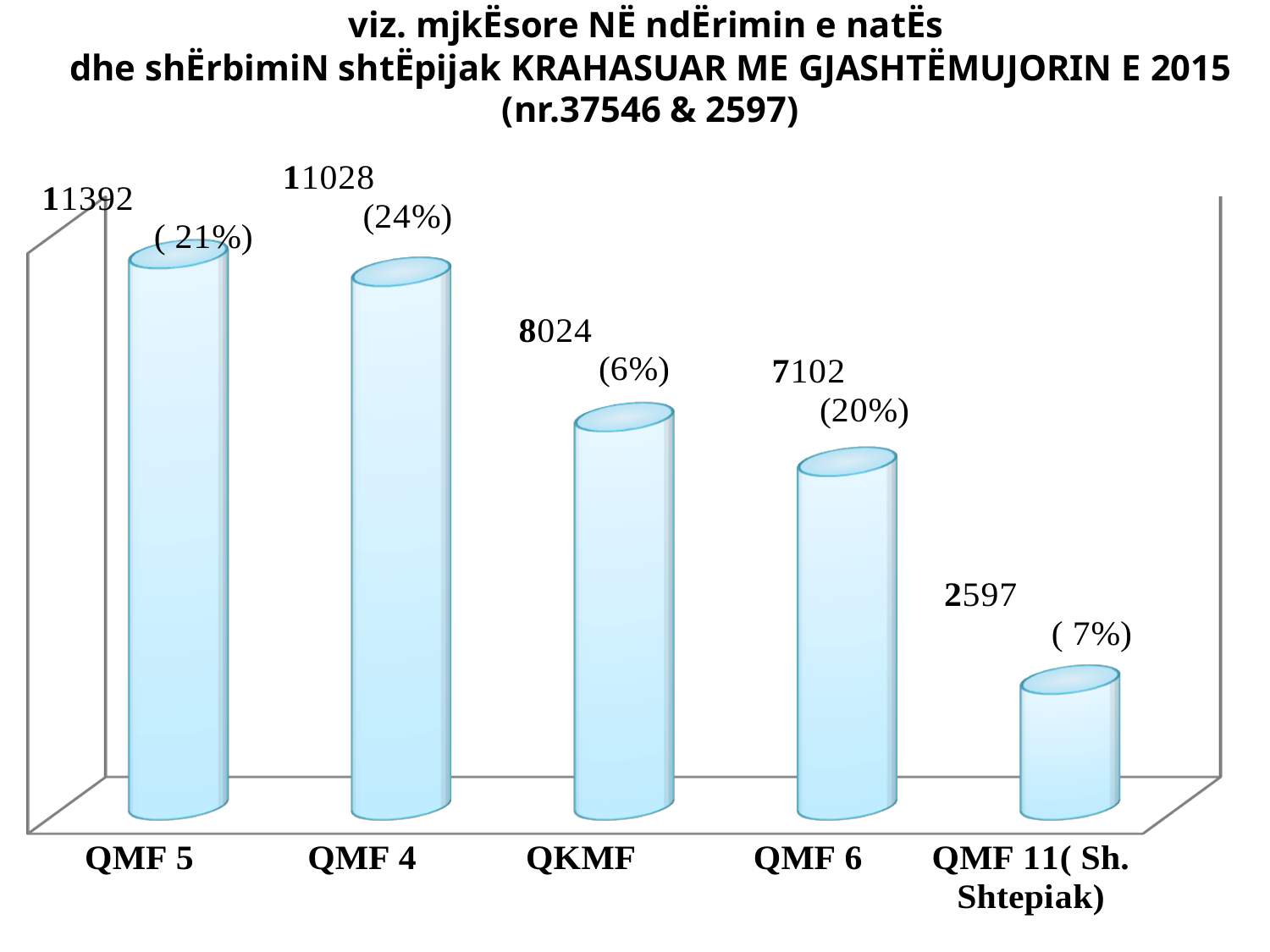
What is the value shown for QMF 5? 11392 How many categories are shown on the x axis? 5 What is the value shown for QKMF? 8024 Which is larger, the value for QMF 6 or the value for QMF 11 (Sh. Shtepiak)? QMF 6 What is the difference between the values for QMF 5 and QMF 4? 364 What percentage is shown in parentheses next to the QMF 4 bar? 24% What kind of chart is shown on the slide? Bar chart Which category has the lowest value? QMF 11 (Sh. Shtepiak) What is the difference between the values for QKMF and QMF 6? 922 What percentage is shown in parentheses next to the QMF 6 bar? 20% Which category has the highest value? QMF 5 What is the value shown for QMF 11 (Sh. Shtepiak)? 2597